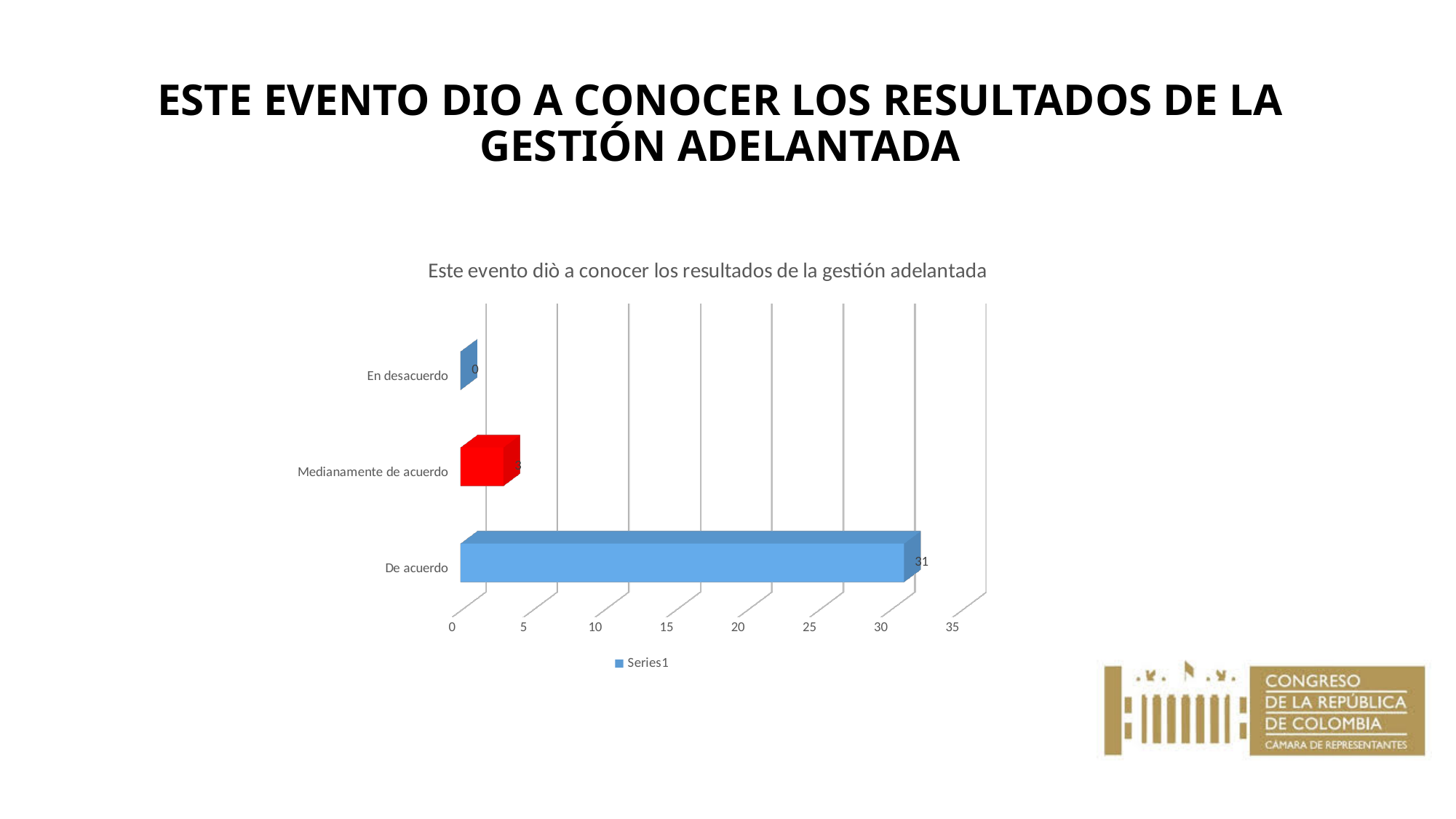
Is the value for De acuerdo greater or less than 30? greater How many categories are shown in the chart? 3 Which is larger, the value for De acuerdo or the value for Medianamente de acuerdo? De acuerdo Is the value for Medianamente de acuerdo greater or less than 5? less How many series does the legend list? 1 Which category has the highest value? De acuerdo What is the value for De acuerdo? 31 What is the name of the series shown in the legend? Series1 What is the difference between the value for De acuerdo and the value for En desacuerdo? 31 What is the value for En desacuerdo? 0 Which category has the lowest value? En desacuerdo What kind of chart is shown on the slide? bar chart